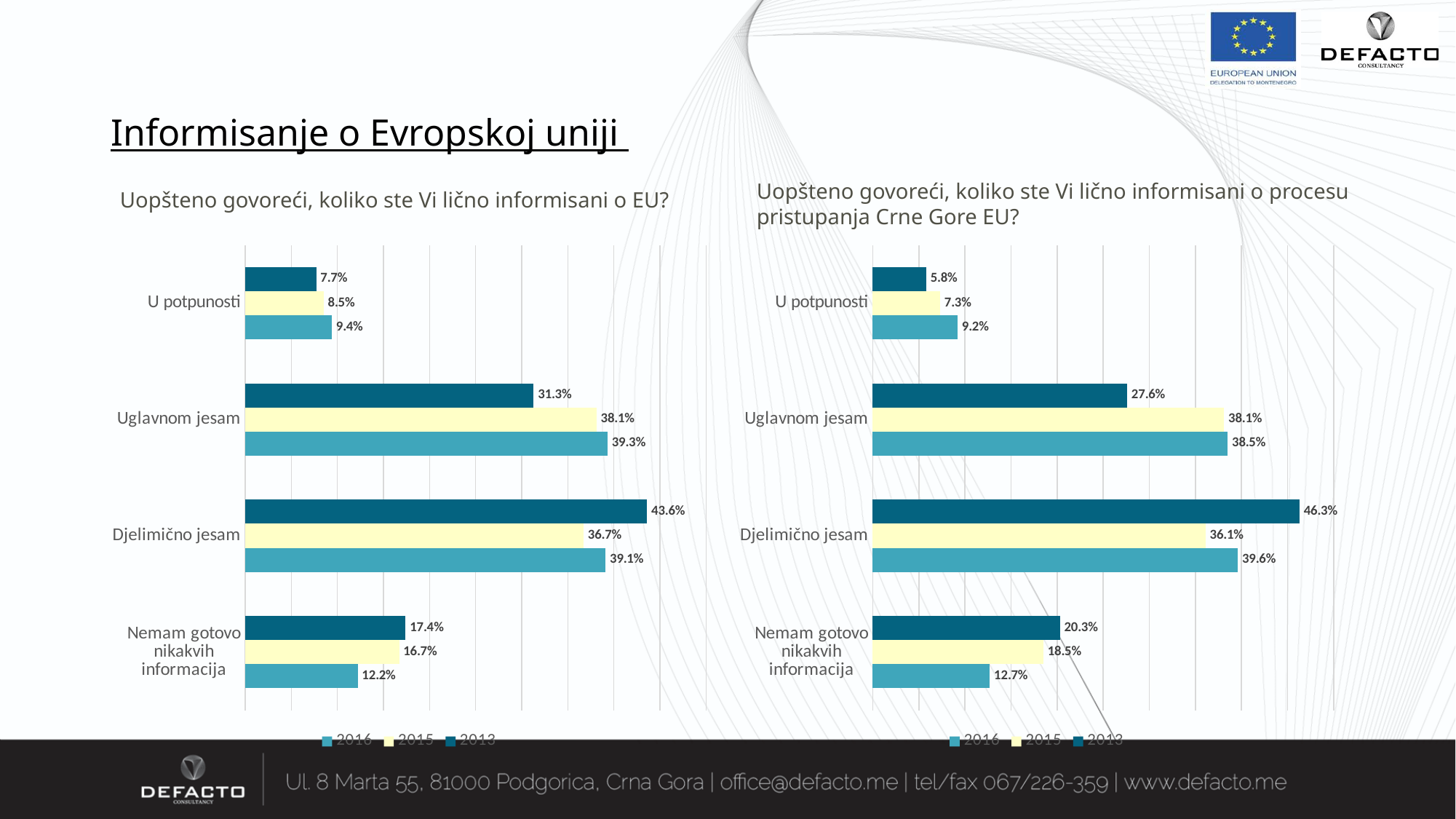
How many series does the legend of the right chart list? 3 In the right chart, which is larger for "Uglavnom jesam": the 2013 value or the 2016 value? 2016 In the left chart, what is the 2013 value for "Djelimično jesam"? 43.6% In the left chart, which is larger for "U potpunosti": the 2015 value or the 2013 value? 2015 In the right chart, what is the 2016 value for "Nemam gotovo nikakvih informacija"? 12.7% In the left chart, what is the difference between the 2016 and 2013 values for "Nemam gotovo nikakvih informacija"? 5.2% In the right chart, what is the difference between the 2013 and 2015 values for "Djelimično jesam"? 10.2% How many categories are shown in the left chart? 4 In the right chart, what is the 2015 value for "Uglavnom jesam"? 38.1% In the left chart, which category has the lowest 2016 value? U potpunosti In the right chart, which category has the highest 2013 value? Djelimično jesam What type of chart is the left chart? Bar chart